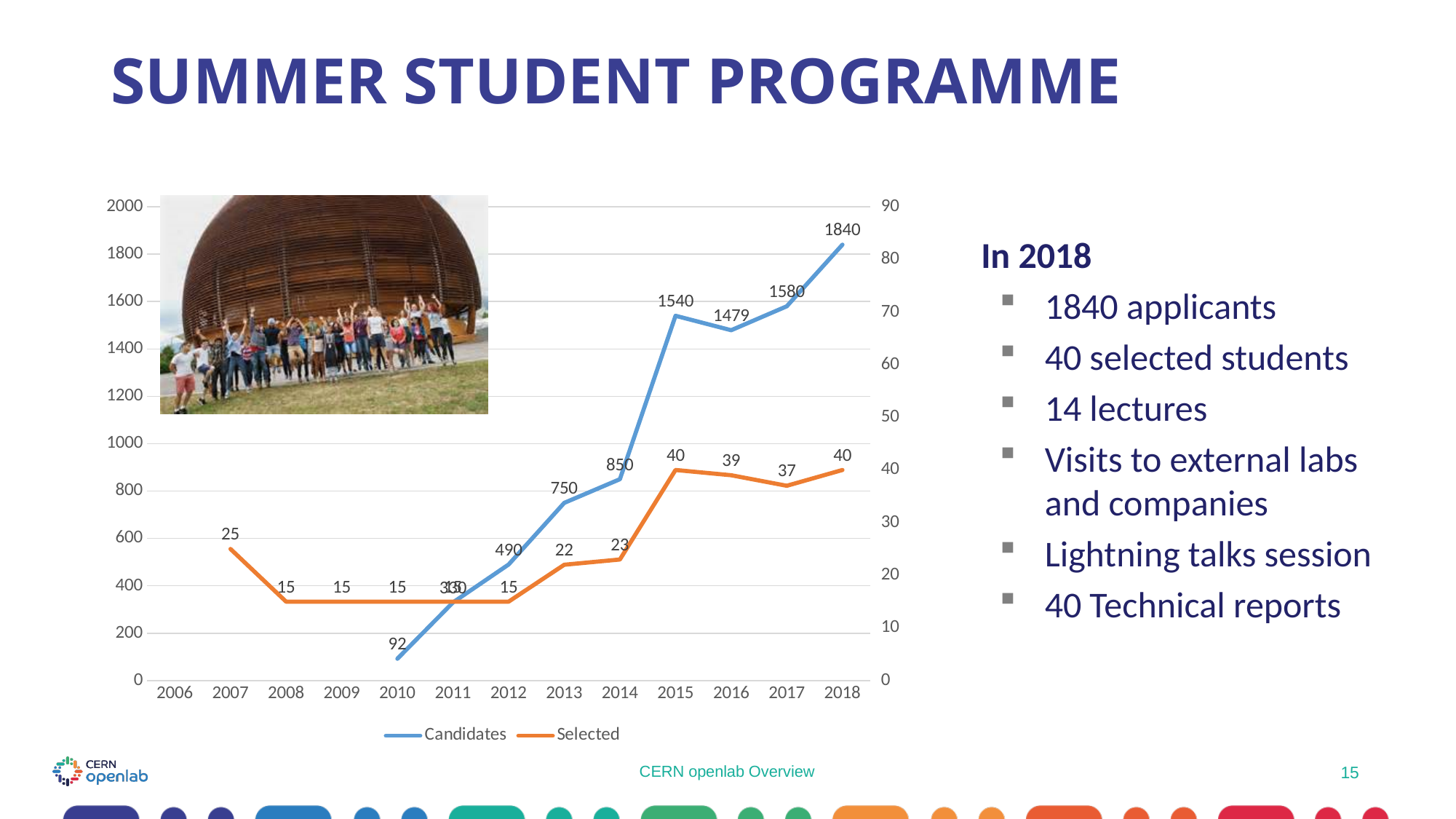
What is the number of Selected in 2007? 25 What are the two series named in the chart legend? Candidates and Selected In which year is the Candidates value lowest? 2010 What is the number of Candidates in 2016? 1479 What is the number of Candidates in 2018? 1840 What is the difference between the Selected values in 2015 and 2014? 17 In which year is the Candidates value highest? 2018 What type of chart is shown on the slide? line chart What is the number of Selected in 2017? 37 How many series does the chart legend list? 2 Which is larger, the Candidates value in 2015 or in 2016? 2015 What is the difference between the Candidates values in 2018 and 2017? 260